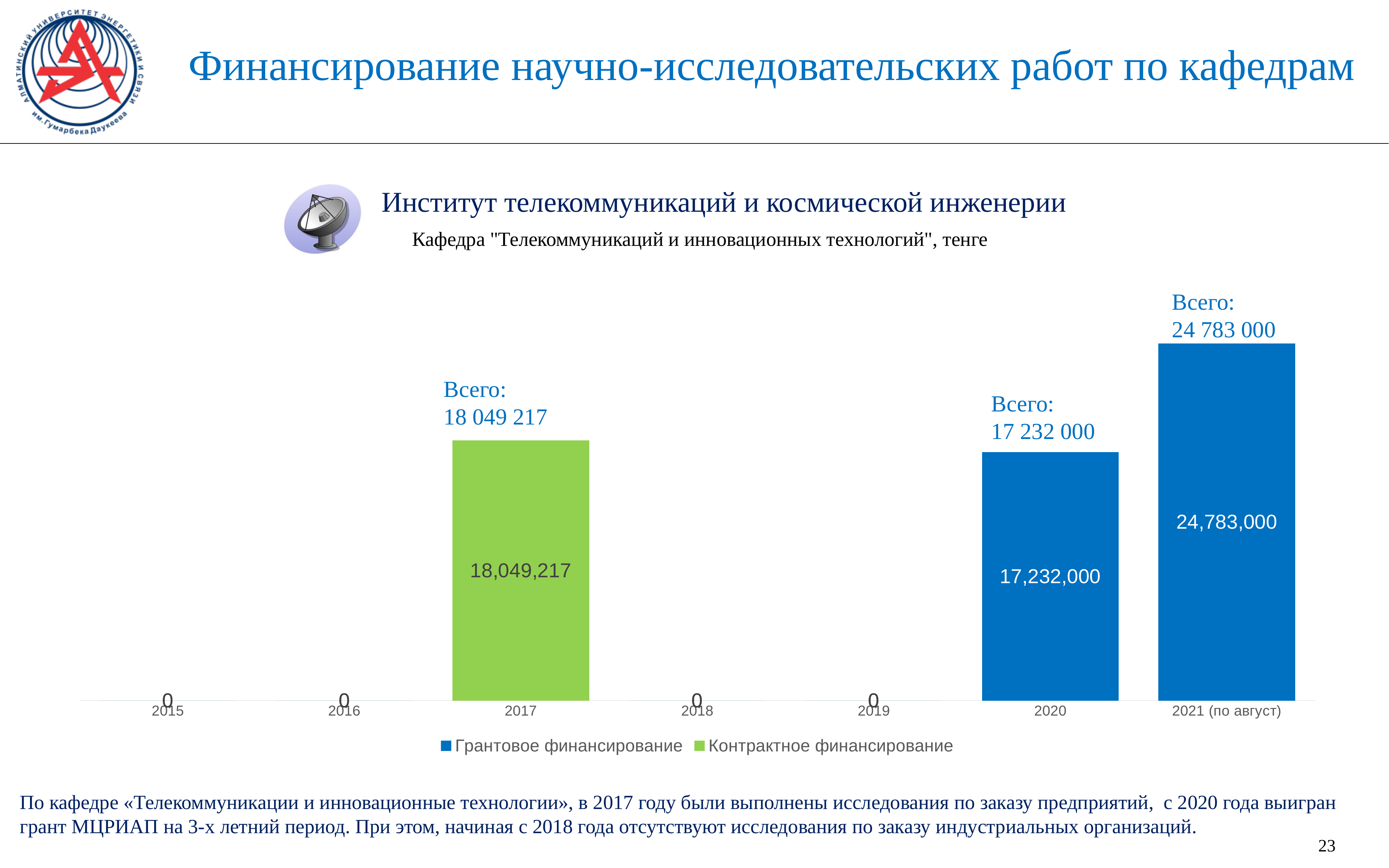
What is the difference between the 2021 (по август) value and the 2020 value? 7,551,000 What is the value of Контрактное финансирование for 2017? 18,049,217 How many year categories are shown on the x axis? 7 What is the value of Грантовое финансирование for 2020? 17,232,000 What is the value of Грантовое финансирование for 2021 (по август)? 24,783,000 How many series does the legend list? 2 Which year has the highest funding value? 2021 (по август) Which is larger, the value for 2017 or the value for 2020? 2017 Which series is shown in green in the legend? Контрактное финансирование What is the total (Всего) shown for 2020? 17 232 000 What kind of chart is shown on the slide? bar chart What value is shown for 2018? 0